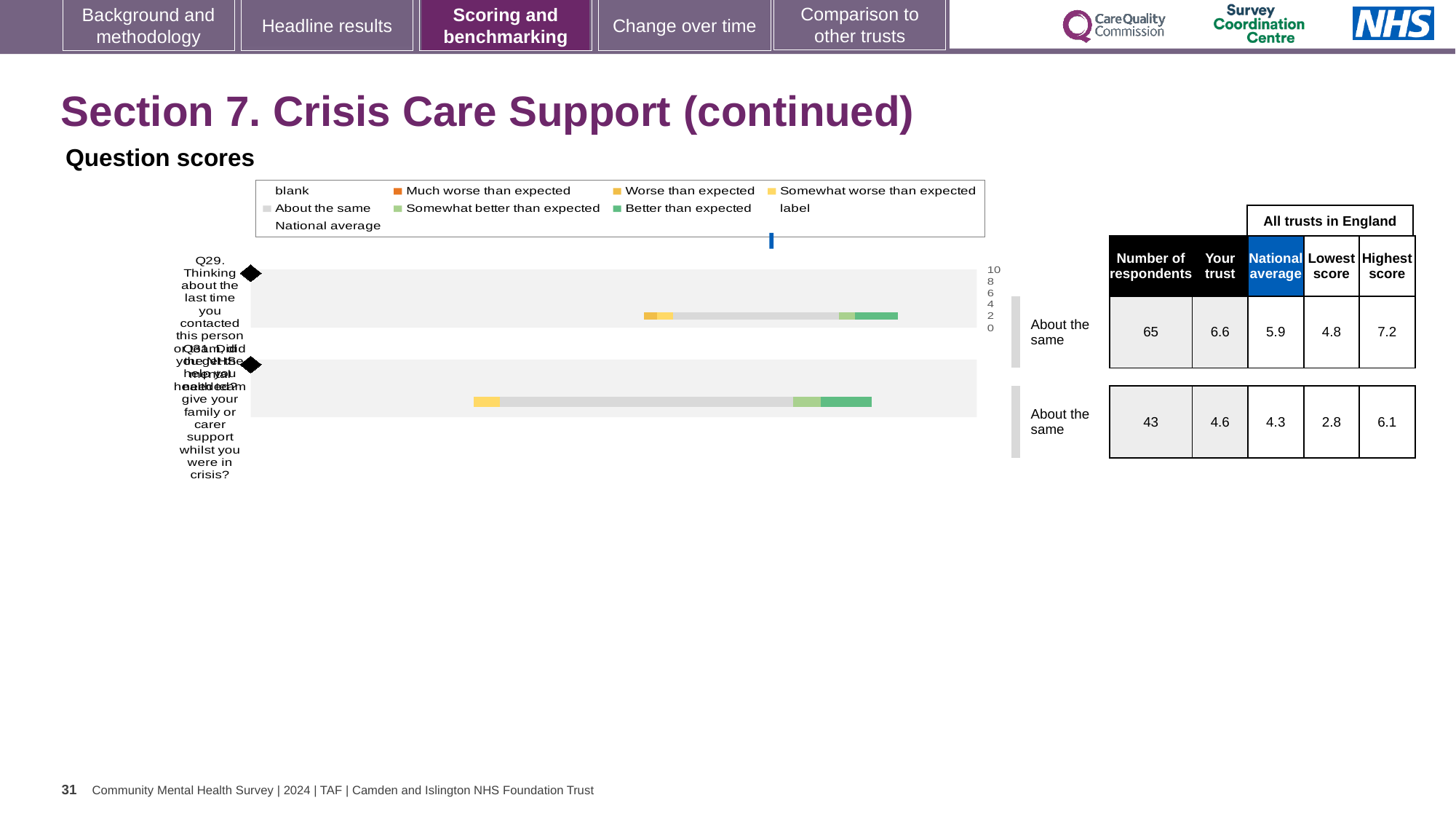
How many respondents answered Q29? 65 Which question has the higher 'Your trust' score, Q29 or Q31? Q29 What benchmark category is shown for Q31? About the same What kind of chart is shown under 'Question scores'? bar chart What is the difference between the highest and lowest scores for Q31? 3.3 What is the highest score among all trusts in England for Q31? 6.1 For Q29, is the 'Your trust' score or the national average larger? Your trust What is the national average for Q31? 4.3 What is the lowest score among all trusts in England for Q29? 4.8 What is the 'Your trust' score for Q29? 6.6 How many questions are plotted in the Question scores chart? 2 What is the difference between the 'Your trust' score and the national average for Q29? 0.7